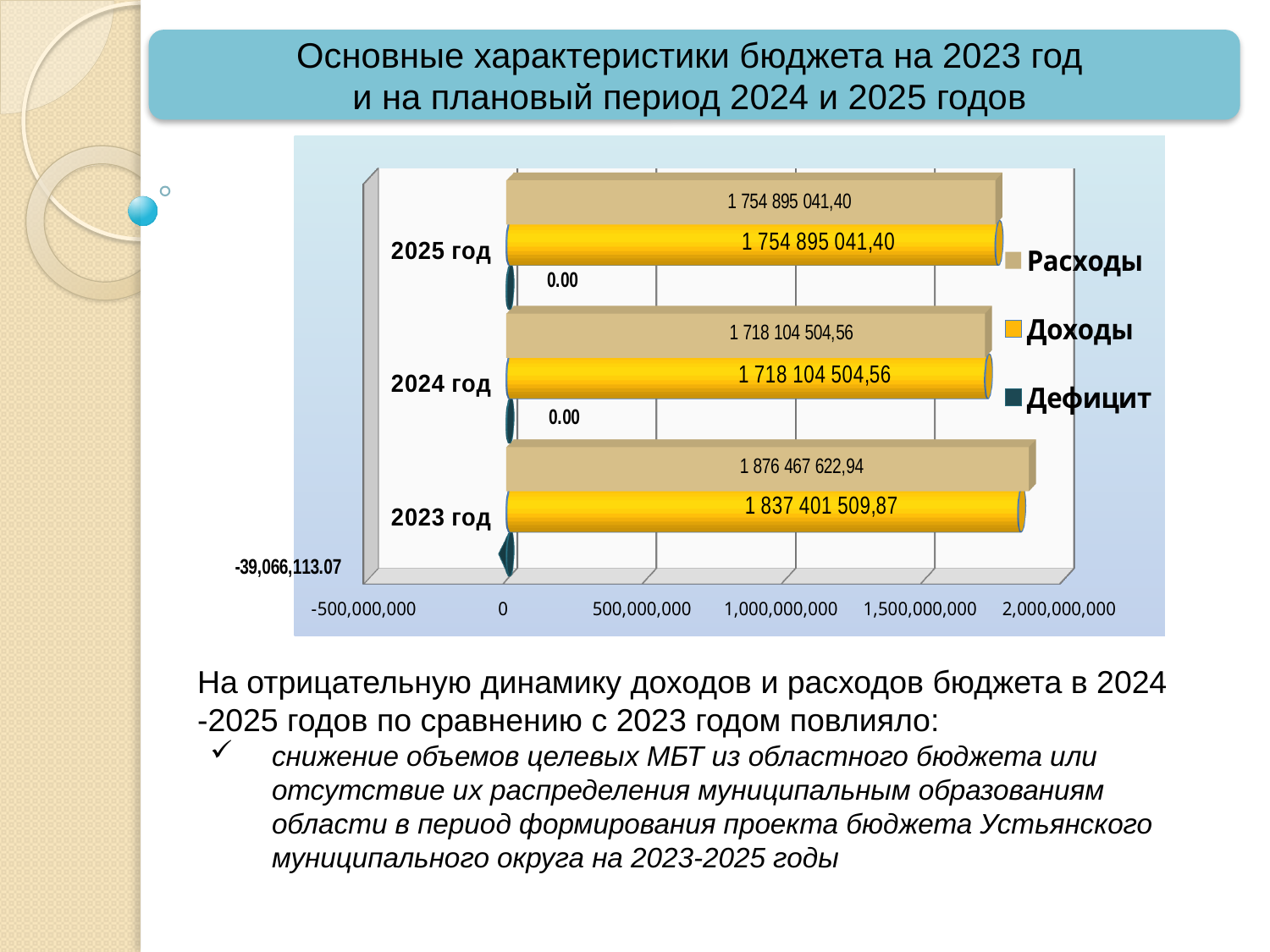
What is the value of Дефицит for 2023 год? -39,066,113.07 Is the value of Доходы for 2023 год greater or less than 1,500,000,000? greater What is the value of Дефицит for 2024 год? 0.00 What is the value of Расходы for 2023 год? 1 876 467 622,94 What is the difference between Расходы and Доходы for 2023 год? 39 066 113,07 What is the value of Доходы for 2024 год? 1 718 104 504,56 What is the value of Доходы for 2025 год? 1 754 895 041,40 What kind of chart is shown on the slide? bar chart Which is larger: Расходы for 2024 год or Расходы for 2025 год? Расходы for 2025 год Which year has the lowest value of Доходы? 2024 год Which year has the highest value of Расходы? 2023 год How many series does the legend list? 3